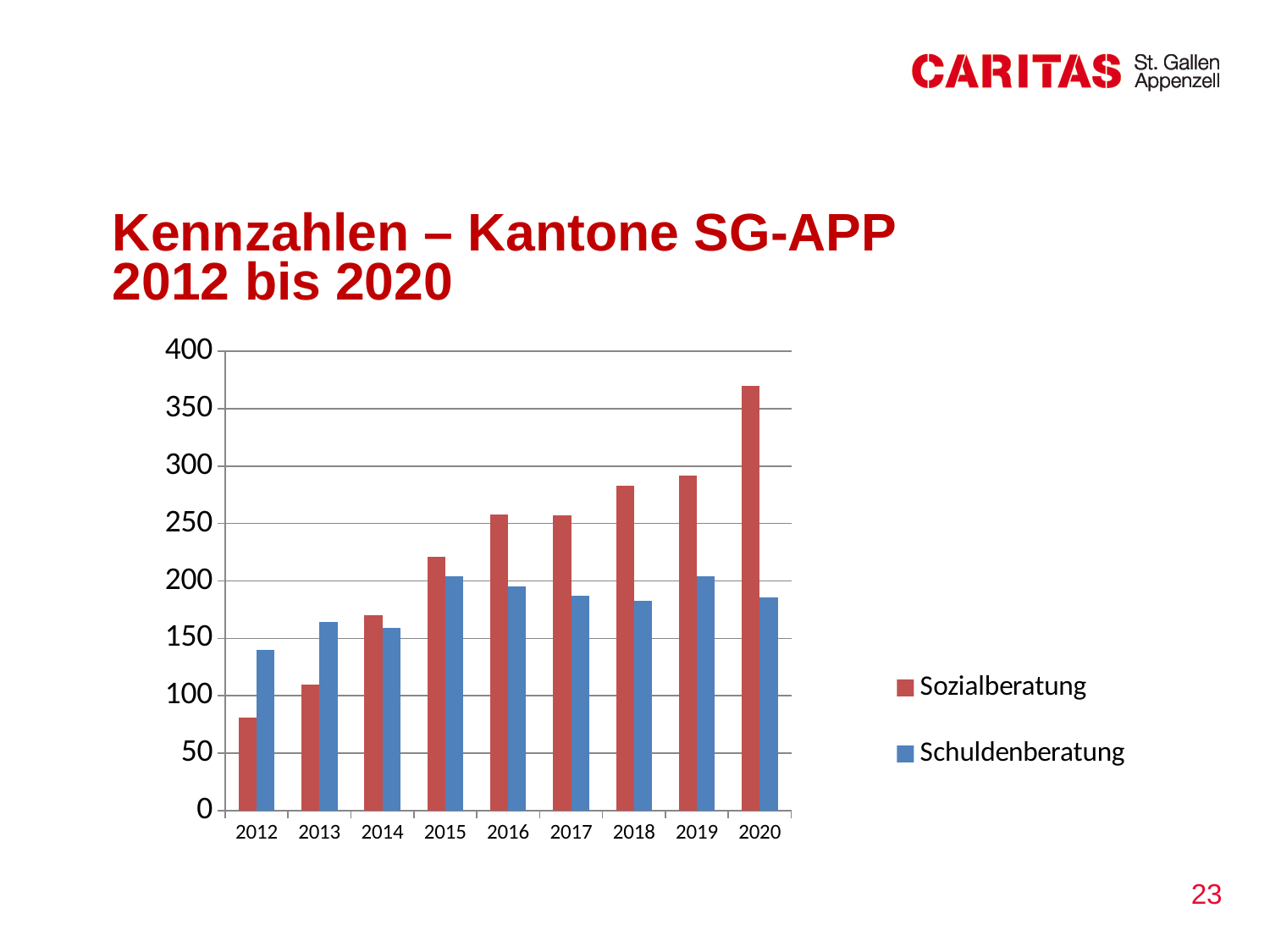
How many series does the legend list? 2 In which year is the Sozialberatung value lowest? 2012 In which year is the Schuldenberatung value lowest? 2012 Which series is shown in blue? Schuldenberatung How many years are shown on the x axis? 9 In which year is the Sozialberatung value highest? 2020 Does the Sozialberatung value generally rise or fall from 2012 to 2020? rise What kind of chart is shown on the slide? bar chart In 2020, which is larger: Sozialberatung or Schuldenberatung? Sozialberatung In 2012, which is larger: Sozialberatung or Schuldenberatung? Schuldenberatung Is the Sozialberatung value for 2020 greater or less than 350? greater Is the Sozialberatung value for 2012 greater or less than 100? less